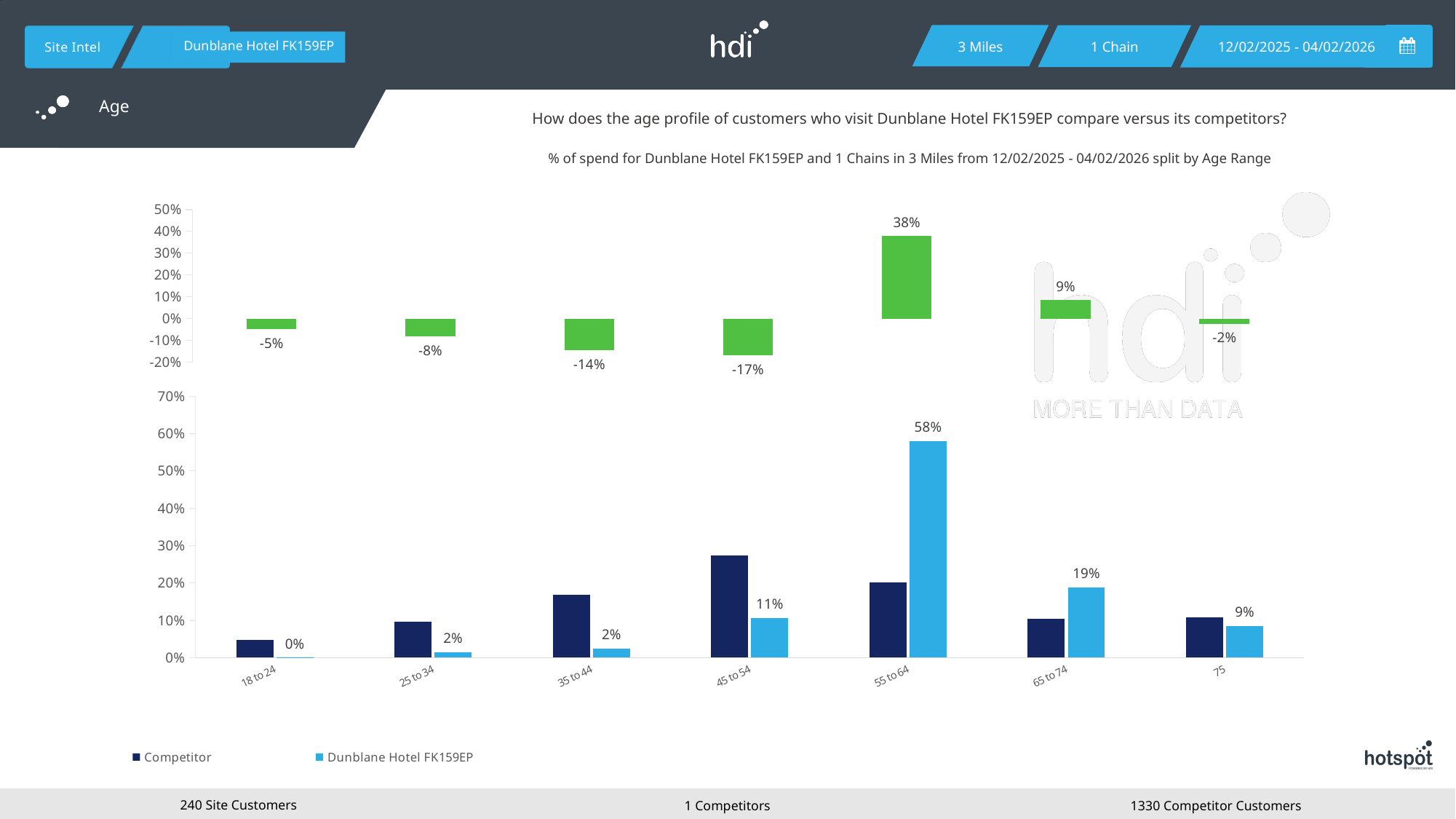
What type of chart is the bottom chart? Bar chart In the top chart, which age range has the highest value? 55 to 64 How many age range categories are shown in the bottom chart? 7 In the bottom chart, is the Competitor value for 18 to 24 greater or less than 10%? less In the bottom chart, what is the value for Dunblane Hotel FK159EP in the 55 to 64 age range? 58% In the bottom chart, is the Competitor value for 45 to 54 greater or less than 20%? greater In the top chart, which age range has the lowest value? 45 to 54 How many series does the legend of the bottom chart list? 2 In the bottom chart, which age range has the lowest value for Dunblane Hotel FK159EP? 18 to 24 In the top chart, what is the value shown for the 45 to 54 age range? -17% In the bottom chart, which is larger for the 45 to 54 age range: the Competitor bar or the Dunblane Hotel FK159EP bar? Competitor In the bottom chart, what is the difference between the Dunblane Hotel FK159EP values for 55 to 64 and 65 to 74? 39%